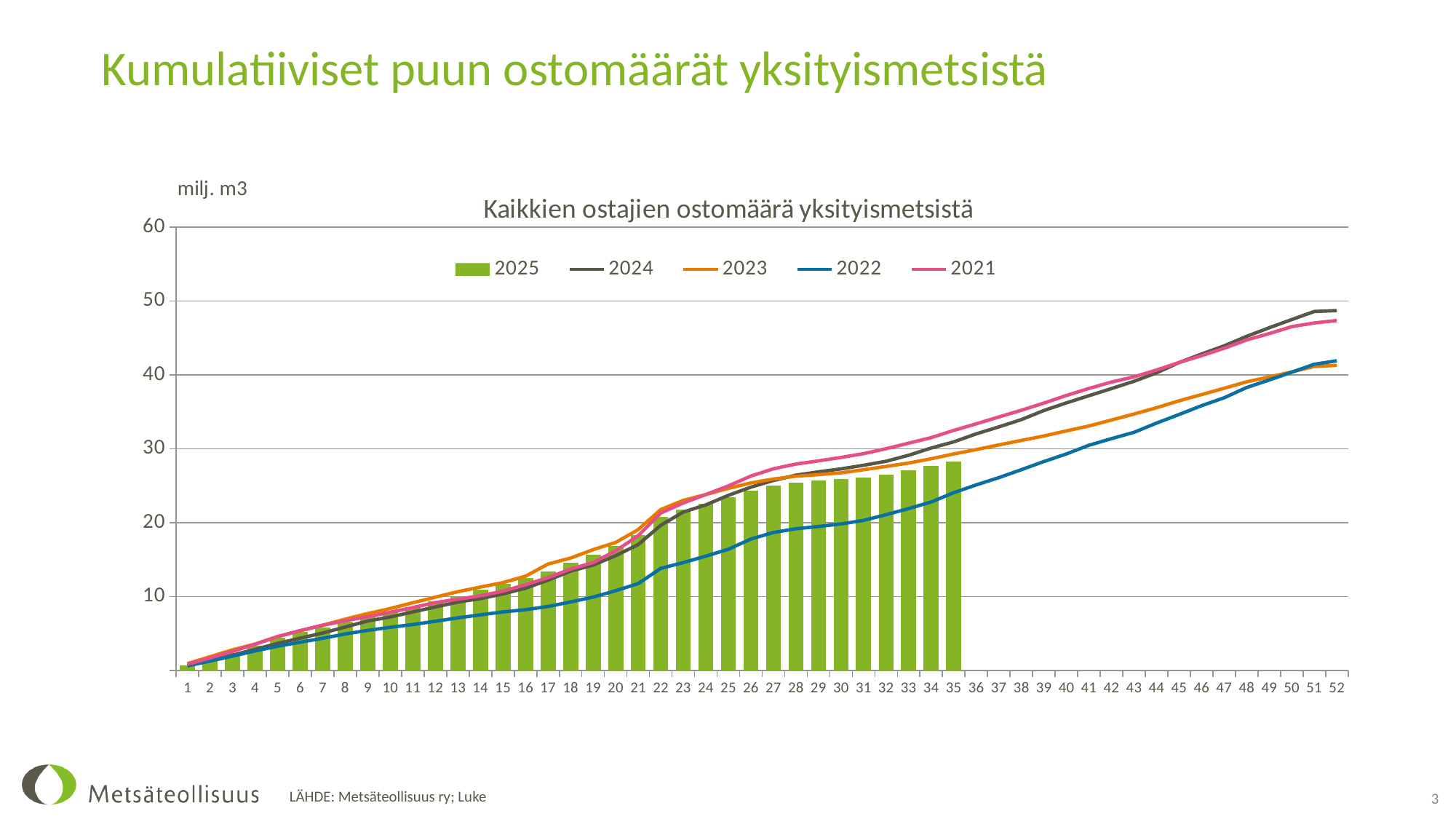
Is the value of the 2024 line at week 52 greater or less than 40? greater What kind of chart is shown on the slide? A combination of a bar chart and line chart What unit is shown on the y axis of the chart? milj. m3 At week 40, which series has the larger value, 2021 or 2022? 2021 What is the title of the chart? Kaikkien ostajien ostomäärä yksityismetsistä Up to which week are bars plotted for the 2025 series? 35 Is the value of the 2022 line at week 25 greater or less than 20? less Is the value of the 2025 bar at week 35 greater or less than 20? greater How many series does the legend list? 5 Do the cumulative values for each series rise or fall along the x axis? Rise Which series has the lowest value at week 30? 2022